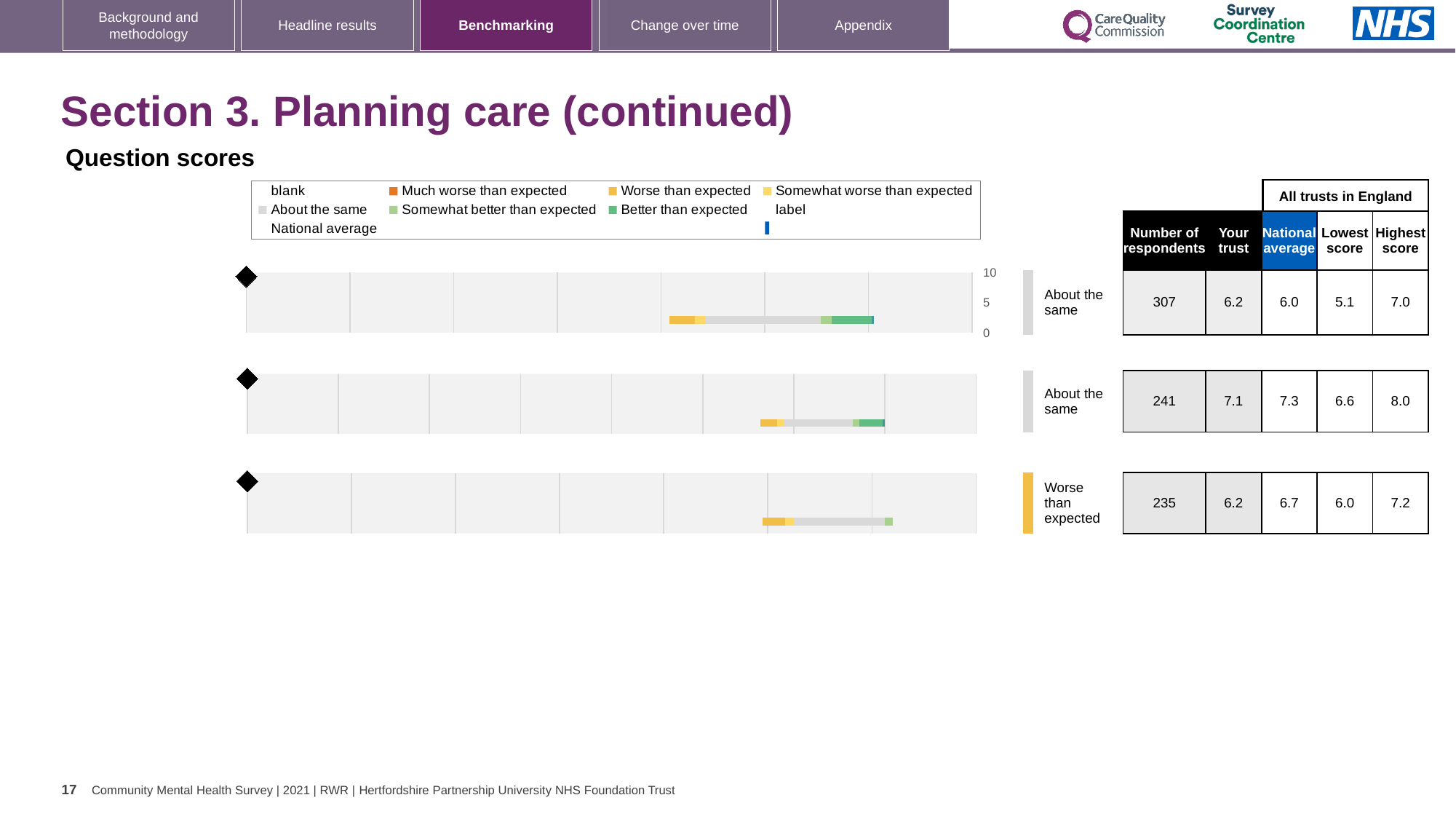
How many benchmarking bar charts are shown on the slide? 3 Which chart has the lowest number of respondents? the third (bottom) chart What is the highest value shown on the vertical axis scale next to the first chart? 10 What kind of chart is used to show the question scores on this slide? bar chart For the third (bottom) chart, what is the national average score? 6.7 For the first (top) chart, what is the number of respondents? 307 Which chart has the highest 'Your trust' score? the second (middle) chart For the third (bottom) chart, what is the lowest score among all trusts in England? 6.0 For the second (middle) chart, which is larger: the 'Your trust' score or the national average? national average For the second (middle) chart, what is the 'Your trust' score? 7.1 What benchmark category is given for the third (bottom) chart? Worse than expected For the first (top) chart, what is the difference between the highest score and the lowest score? 1.9